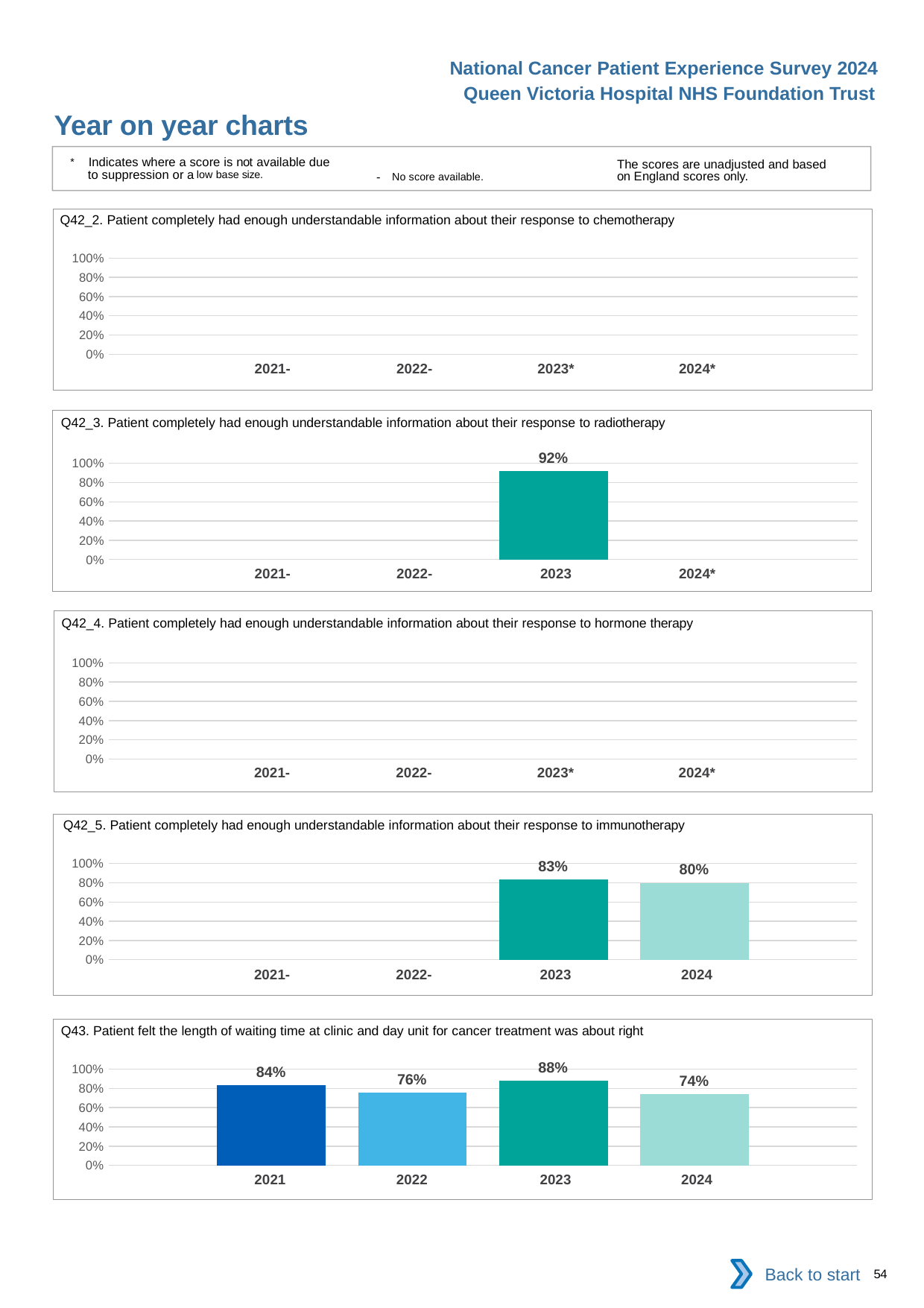
In the Q42_5 chart about immunotherapy, what is the value for 2024? 80% In the Q42_5 chart about immunotherapy, which is larger, the 2023 value or the 2024 value? 2023 In the Q43 chart about waiting time at clinic and day unit, what is the value for 2023? 88% What kind of chart is the Q43 chart about waiting time at clinic and day unit? Bar chart In the Q43 chart about waiting time at clinic and day unit, what is the value for 2021? 84% In the Q42_3 chart about radiotherapy, how many years have a bar plotted? 1 In the Q43 chart about waiting time at clinic and day unit, how many years have a bar plotted? 4 In the Q43 chart about waiting time at clinic and day unit, which year has the highest value? 2023 In the Q42_5 chart about immunotherapy, what is the difference between the 2023 and 2024 values? 3 percentage points In the Q43 chart about waiting time at clinic and day unit, which year has the lowest value? 2024 In the Q43 chart about waiting time at clinic and day unit, what is the difference between the 2023 and 2024 values? 14 percentage points In the Q42_3 chart about radiotherapy, what is the value for 2023? 92%